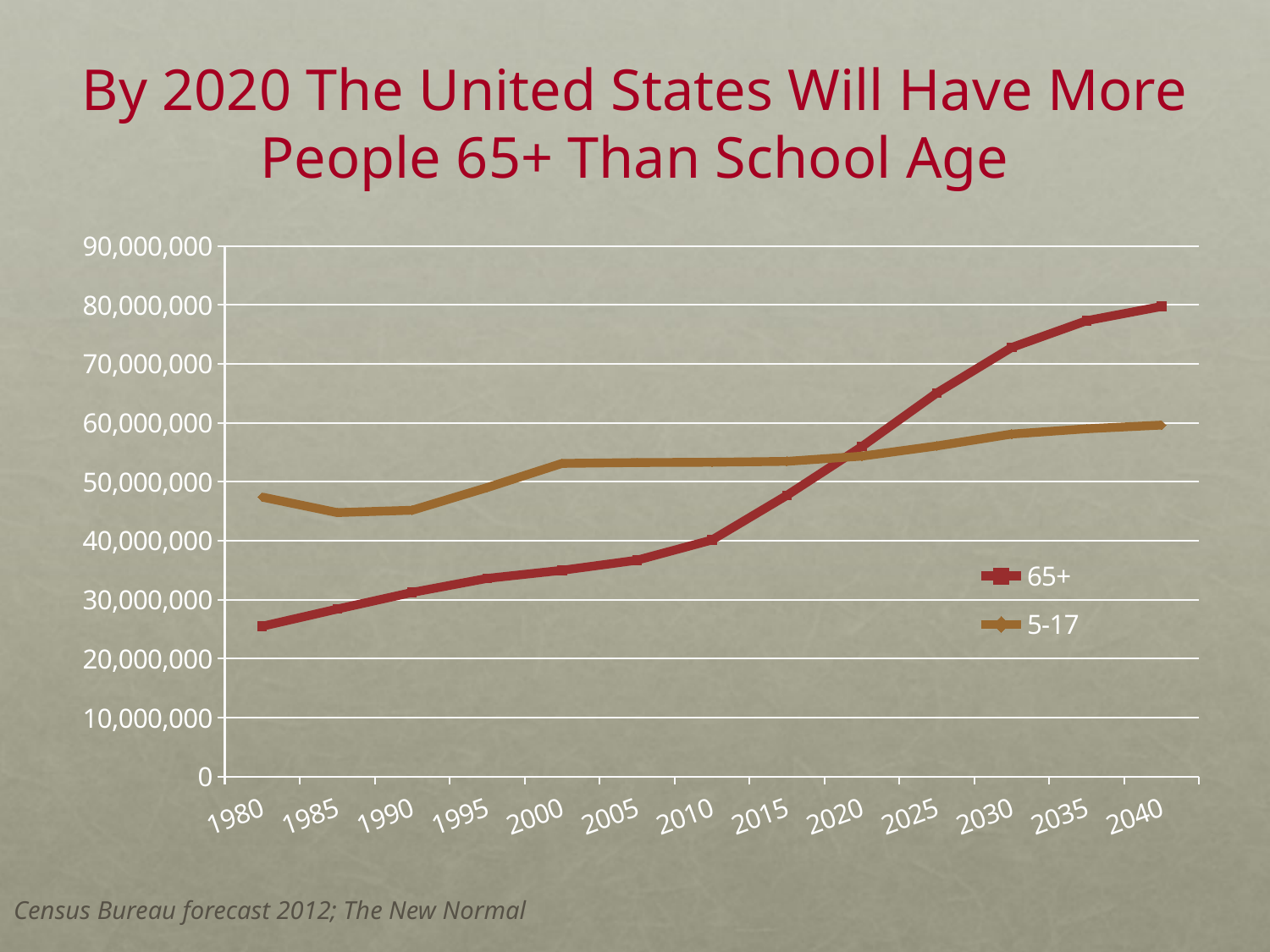
Is the value for 65+ in 1980 greater or less than 30,000,000? less Is the value for 65+ in 2010 greater or less than 50,000,000? less In which year does the 65+ series reach its highest value? 2040 Does the 65+ series rise or fall from 1980 to 2040? rise What are the two series named in the legend? 65+ and 5-17 In 2040, which series has the larger value, 65+ or 5-17? 65+ How many series does the legend list? 2 What kind of chart is shown on the slide? line chart Is the value for 5-17 in 2000 greater or less than 50,000,000? greater How many years are marked along the x axis? 13 In 1980, which series has the larger value, 65+ or 5-17? 5-17